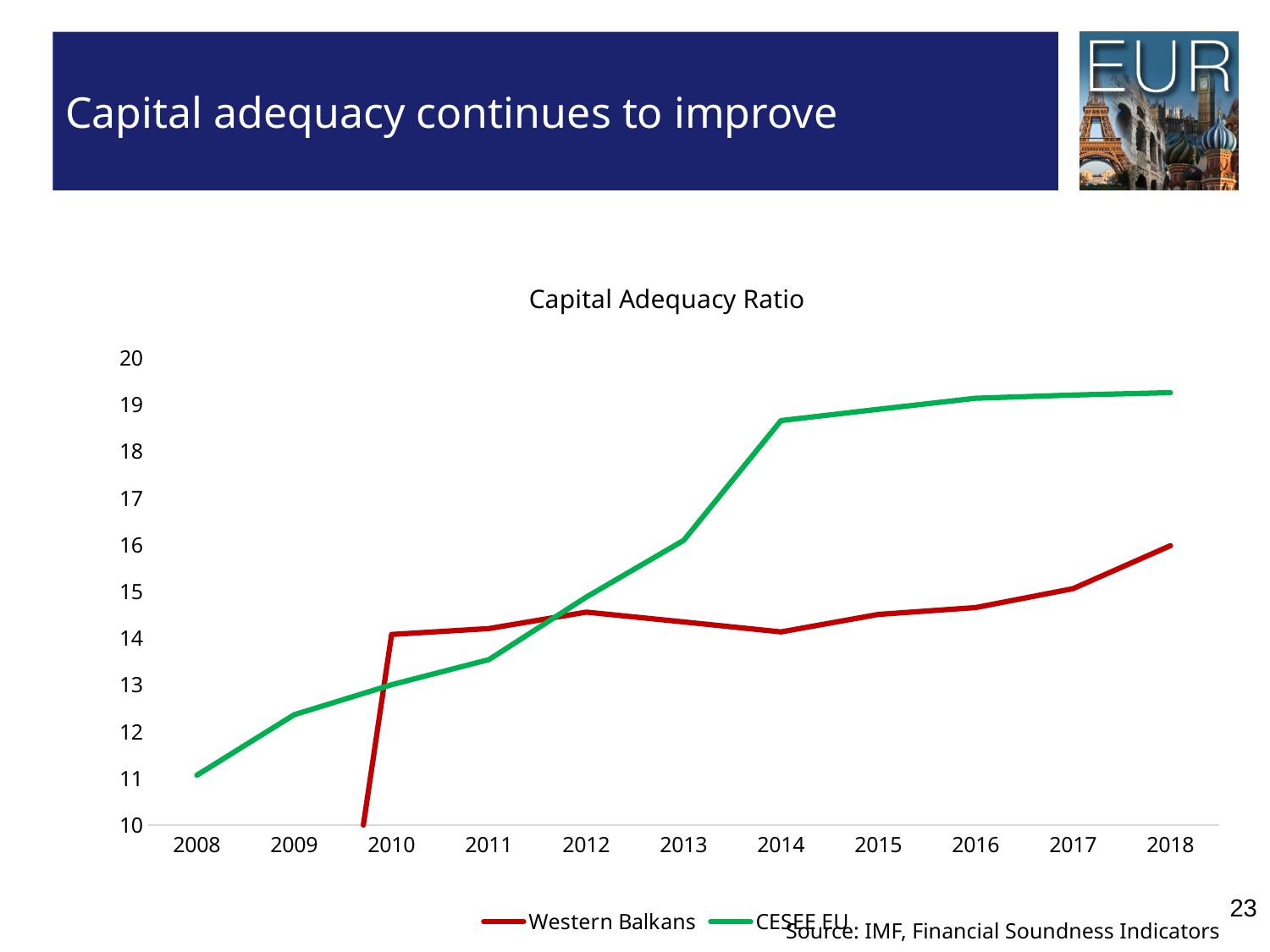
What kind of chart is shown on the slide? Line chart Does the CESEE EU line rise or fall from 2008 to 2018? Rises Is the value for CESEE EU in 2008 greater or less than 12? less Is the value for Western Balkans in 2014 greater or less than 15? less How many years are shown on the x axis? 11 In 2010, which series has the higher capital adequacy ratio, Western Balkans or CESEE EU? Western Balkans Is the value for CESEE EU in 2018 greater or less than 19? greater In 2018, which series has the higher capital adequacy ratio, Western Balkans or CESEE EU? CESEE EU How many series does the legend list? 2 In which year is the CESEE EU value highest? 2018 What colour is the Western Balkans line? Red